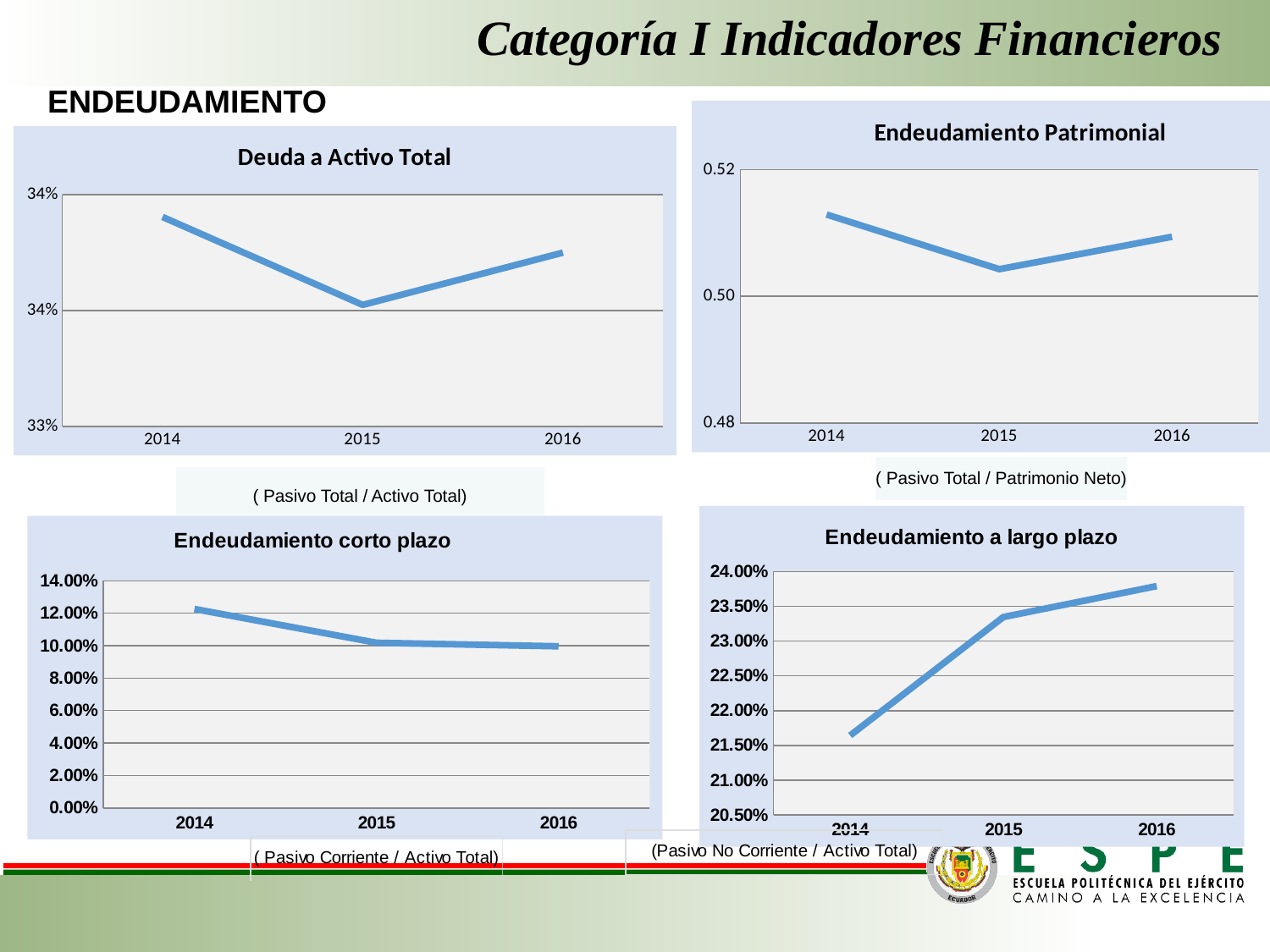
What formula is shown below the "Endeudamiento a largo plazo" chart? (Pasivo No Corriente / Activo Total) In the "Endeudamiento Patrimonial" chart, is the value for 2015 greater or less than 0.50? greater In the "Endeudamiento a largo plazo" chart, do the values rise or fall from 2014 to 2016? rise In the "Endeudamiento corto plazo" chart, is the value for 2014 greater or less than 10.00%? greater What kind of chart is the "Deuda a Activo Total" chart? line chart In the "Endeudamiento Patrimonial" chart, which year has the highest value? 2014 In the "Endeudamiento a largo plazo" chart, is the value for 2014 greater or less than 22.00%? less In the "Endeudamiento Patrimonial" chart, which is larger, the value for 2014 or the value for 2016? 2014 In the "Deuda a Activo Total" chart, which year has the lowest value? 2015 In the "Deuda a Activo Total" chart, how many years are plotted on the x axis? 3 In the "Endeudamiento corto plazo" chart, do the values rise or fall from 2014 to 2016? fall In the "Endeudamiento corto plazo" chart, which year has the highest value? 2014